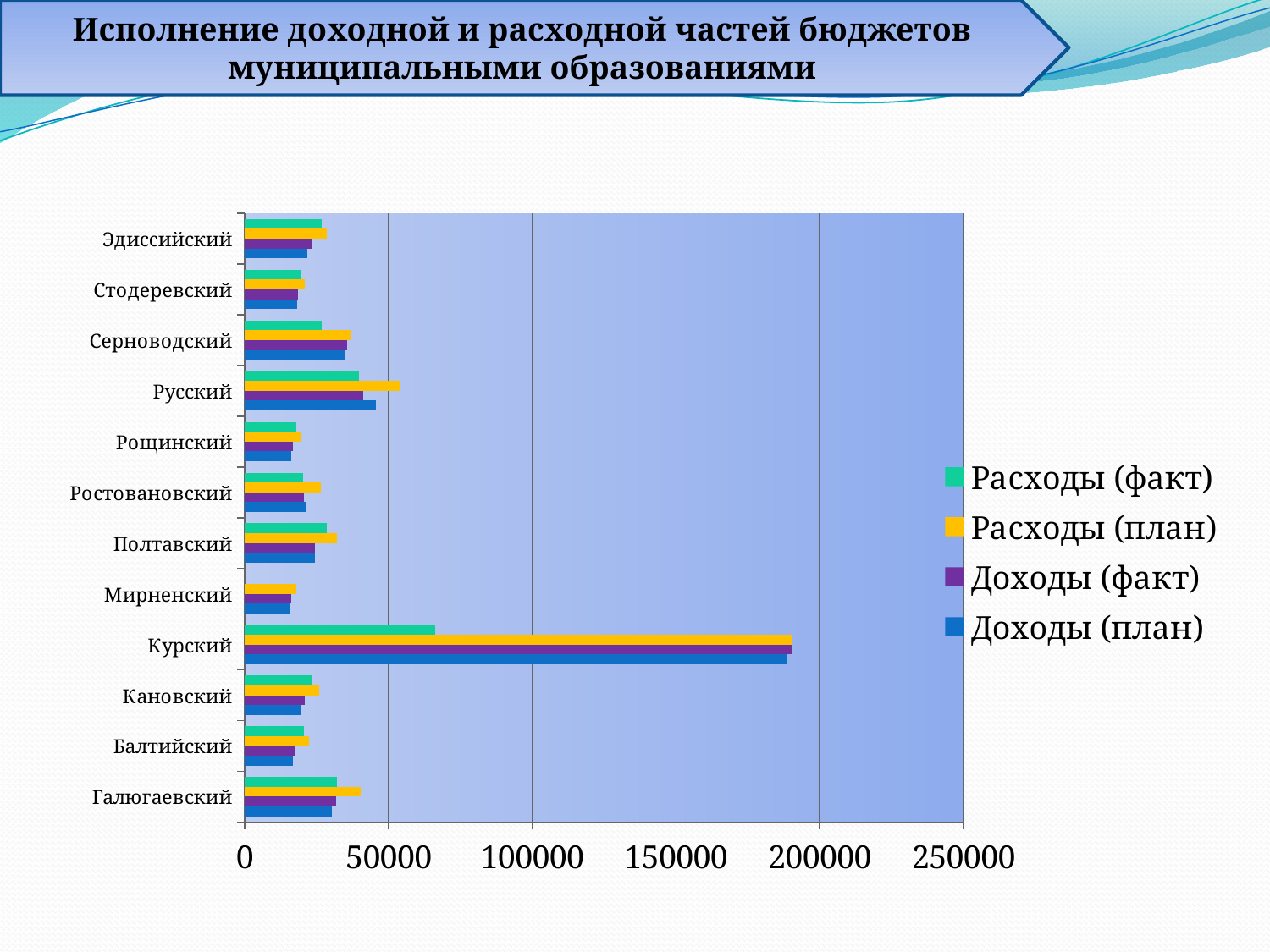
Is the value of Доходы (план) for Курский greater or less than 150000? greater Is the value of Расходы (факт) for Курский greater or less than 50000? greater Which municipality has the highest value for Доходы (план)? Курский Which municipality has the highest value for Расходы (факт)? Курский How many municipalities (categories) are listed on the vertical axis of the chart? 12 What kind of chart is shown on the slide? bar chart What is the title of the slide? Исполнение доходной и расходной частей бюджетов муниципальными образованиями How many series does the chart legend list? 4 For Курский, which is larger: Расходы (план) or Расходы (факт)? Расходы (план) Is the value of Доходы (план) for Русский greater or less than 50000? less Which has the larger Расходы (план) value: Галюгаевский or Балтийский? Галюгаевский